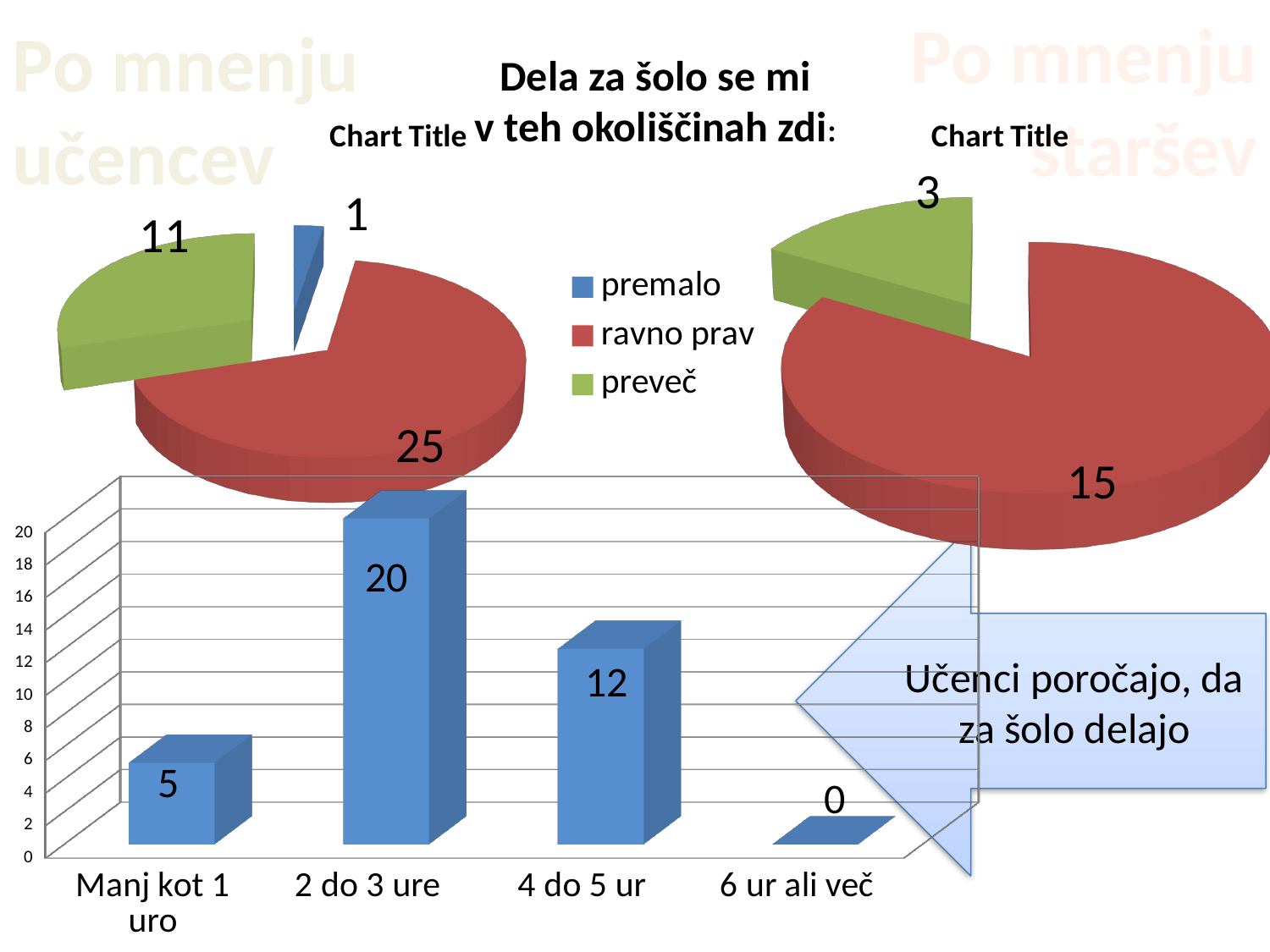
In the bar chart at the bottom of the slide, which category has the lowest value? 6 ur ali več How many entries does the pie chart legend list? 3 In the left pie chart, which slice is the largest? ravno prav In the bar chart at the bottom of the slide, how many categories are shown on the x axis? 4 In the left pie chart, what is the value for 'ravno prav'? 25 In the bar chart at the bottom of the slide, what is the value for 'Manj kot 1 uro'? 5 In the bar chart at the bottom of the slide, what is the difference between the values for '2 do 3 ure' and '4 do 5 ur'? 8 In the right pie chart, what is the value for 'ravno prav'? 15 In the bar chart at the bottom of the slide, what is the value for '2 do 3 ure'? 20 In the bar chart at the bottom of the slide, which category has the highest value? 2 do 3 ure What kind of chart is the chart at the bottom of the slide? bar chart In the left pie chart, what is the value for 'preveč'? 11